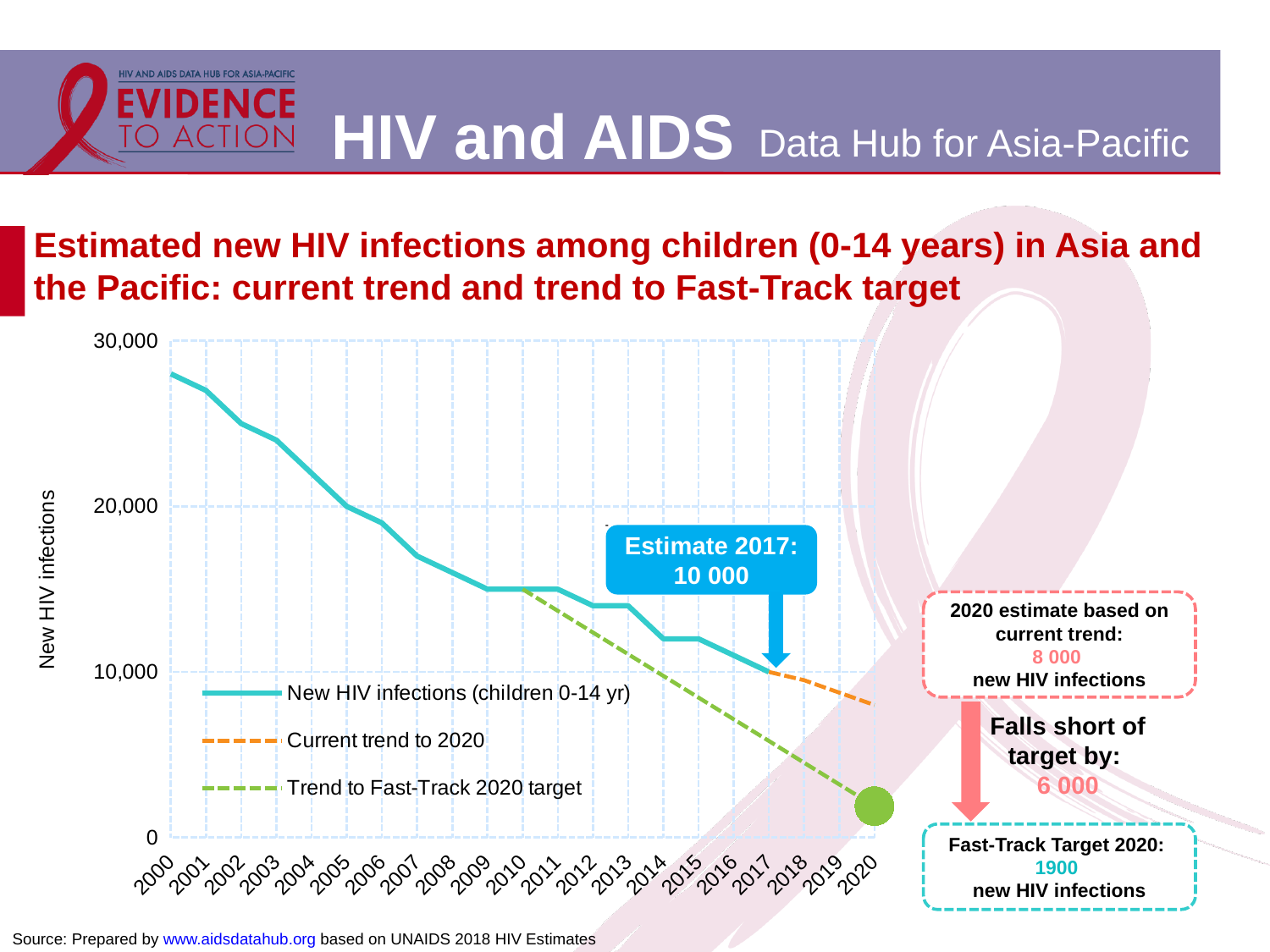
By how much does the 2020 estimate based on the current trend fall short of the Fast-Track target? 6 000 Do new HIV infections among children rise or fall from 2000 to 2017? fall What is the estimated number of new HIV infections among children in 2017, as labelled on the chart? 10 000 What is the Fast-Track Target for new HIV infections in 2020? 1900 Is the value for new HIV infections in 2010 greater or less than 20,000? less How many series does the chart legend list? 3 What is the 2020 estimate of new HIV infections based on the current trend? 8 000 How many years are labelled on the x axis of the chart? 21 What kind of chart is shown on the slide? line chart Which series is drawn as a green dashed line? Trend to Fast-Track 2020 target Which year has the highest number of new HIV infections among children on the chart? 2000 Is the value for new HIV infections in 2000 greater or less than 20,000? greater